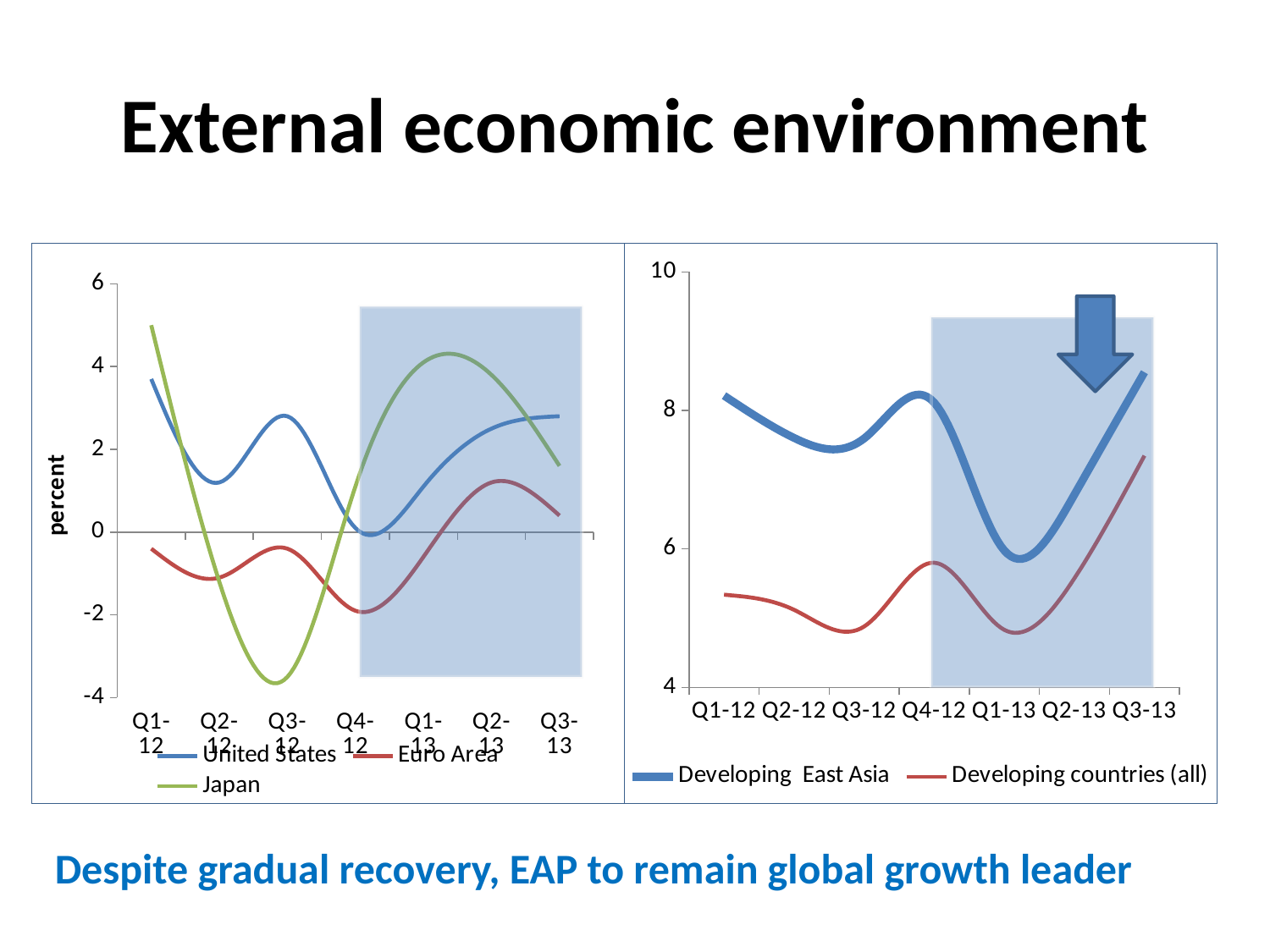
In the left chart, which series has the lowest value at Q3-12? Japan How many quarters are shown on the x axis of the right chart? 7 How many series does the legend of the left chart list? 3 What is the y-axis label of the left chart? percent In the left chart, is the value for Japan at Q1-12 greater or less than 4? greater In the left chart, which series has the highest value at Q1-12? Japan In the right chart, does the Developing East Asia line rise or fall from Q1-13 to Q3-13? rise In the left chart, is the value for Japan at Q3-12 greater or less than -2? less In the right chart, is the value for Developing East Asia at Q3-13 greater or less than 8? greater What kind of chart is the left chart on the slide? line chart In the right chart, which series is larger at Q1-12, Developing East Asia or Developing countries (all)? Developing East Asia How many series does the legend of the right chart list? 2